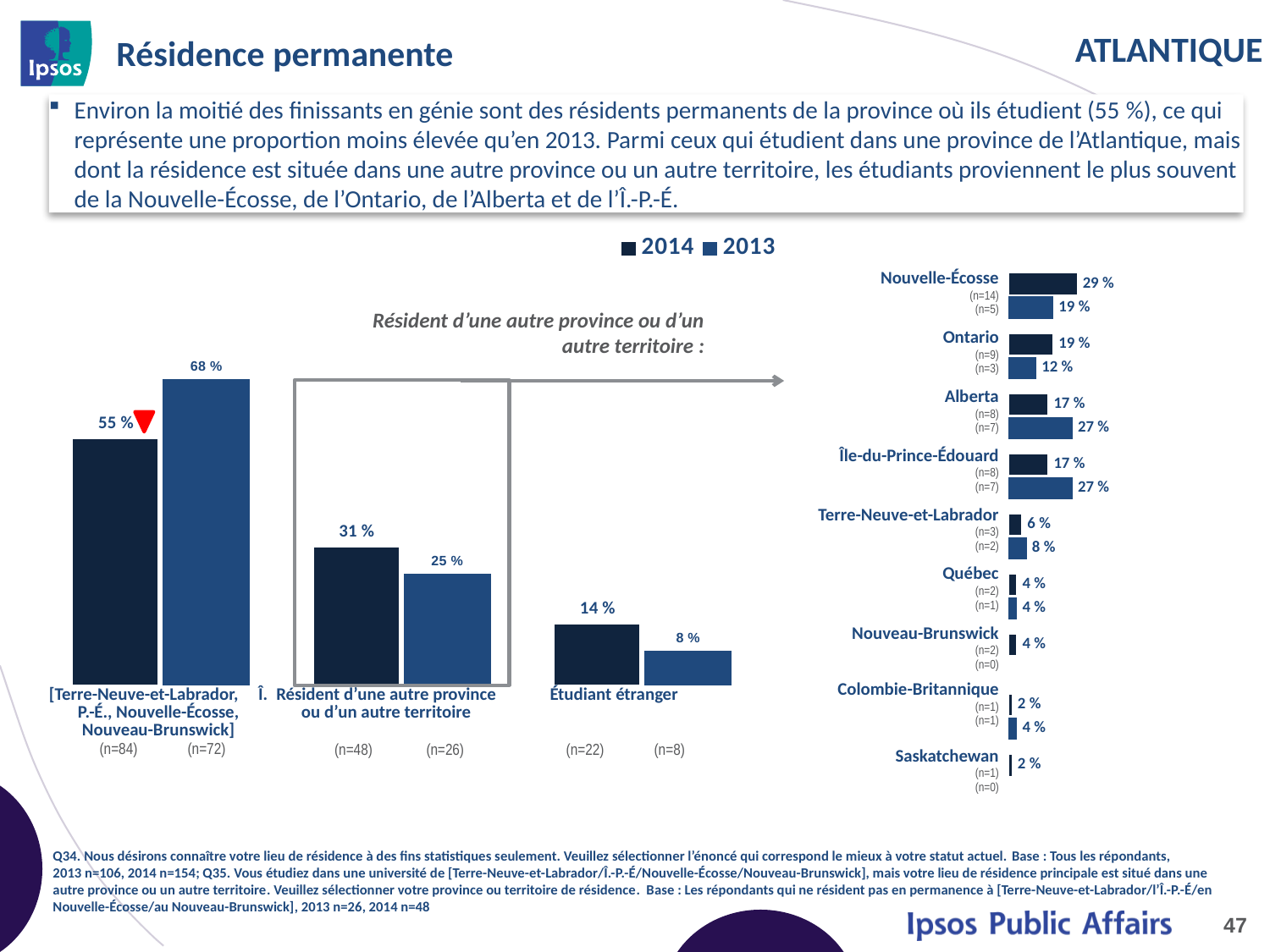
In the left bar chart, what is the 2014 value for 'Étudiant étranger'? 14 % In the left bar chart, which category has the highest 2014 value? [Terre-Neuve-et-Labrador, P.-É., Nouvelle-Écosse, Nouveau-Brunswick] How many series does the legend list? 2 What type of chart is the right chart? Bar chart In the left bar chart, what is the difference between the 2014 and 2013 values for 'Résident d'une autre province ou d'un autre territoire'? 6 % How many provinces or territories are listed in the right chart? 9 In the right chart, which province has the highest 2014 value? Nouvelle-Écosse In the right chart, what is the difference between the 2014 and 2013 values for Ontario? 7 % In the right chart, what is the 2014 value for Nouvelle-Écosse? 29 % In the left bar chart, is the 2014 value for 'Étudiant étranger' larger or smaller than its 2013 value? larger In the left bar chart, what is the 2013 value for the permanent residents category '[Terre-Neuve-et-Labrador, P.-É., Nouvelle-Écosse, Nouveau-Brunswick]'? 68 % In the right chart, what is the 2013 value for Alberta? 27 %